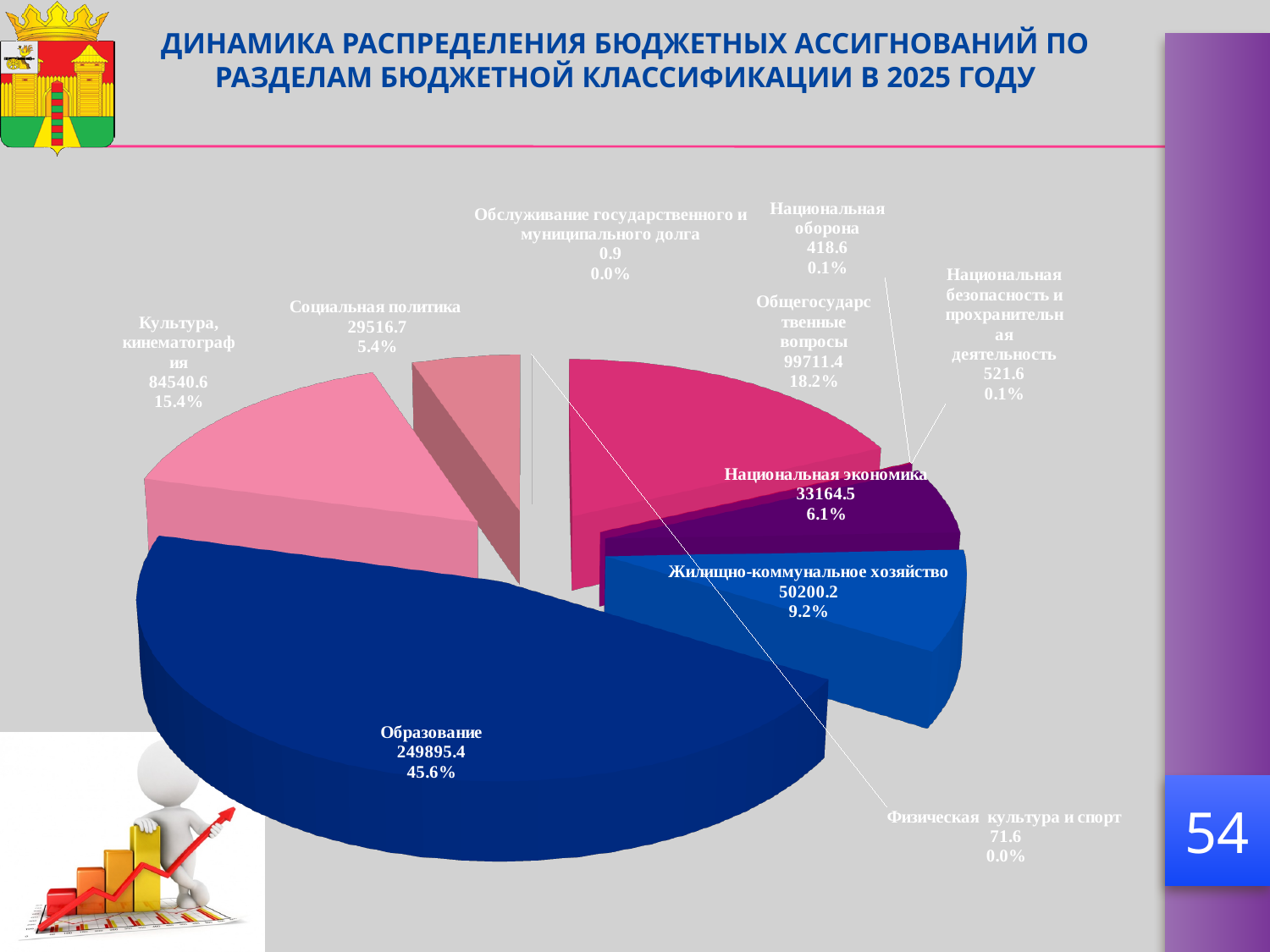
What is the value shown for Национальная оборона? 418.6 Which category has the largest slice of the pie? Образование What year does the chart title refer to? 2025 What share of the pie does Образование represent? 45.6% Which is larger, the value for Социальная политика or the value for Национальная экономика? Национальная экономика What is the difference between the values for Жилищно-коммунальное хозяйство and Национальная экономика? 17035.7 What share of the pie does Культура, кинематография represent? 15.4% Which category has the smallest value in the pie chart? Обслуживание государственного и муниципального долга What is the value shown for Образование? 249895.4 How many categories (slices) does the pie chart show? 10 What is the value shown for Общегосударственные вопросы? 99711.4 What kind of chart is shown on the slide? Pie chart